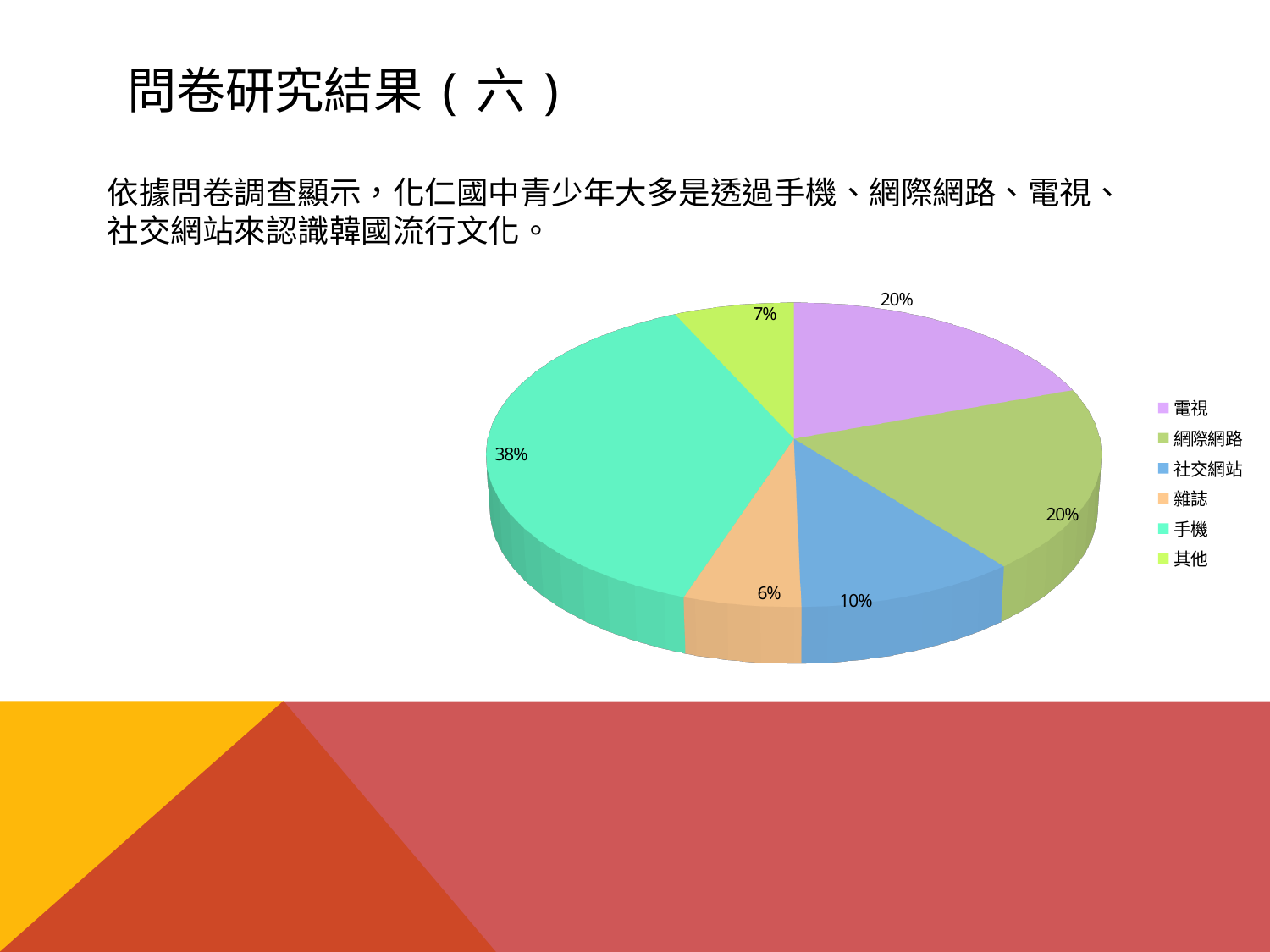
What kind of chart is shown on the slide? pie chart Which category has the smallest slice of the pie? 雜誌 Which category has the largest slice of the pie? 手機 What share of the pie does 其他 have? 7% What share of the pie does 雜誌 have? 6% What share of the pie does 手機 have? 38% What is the difference between the shares of 手機 and 網際網路? 18% How many categories does the pie chart have? 6 What share of the pie does 電視 have? 20% Which colour represents 手機 in the pie chart? teal (green) What share of the pie does 社交網站 have? 10% Which has a larger share, 社交網站 or 其他? 社交網站